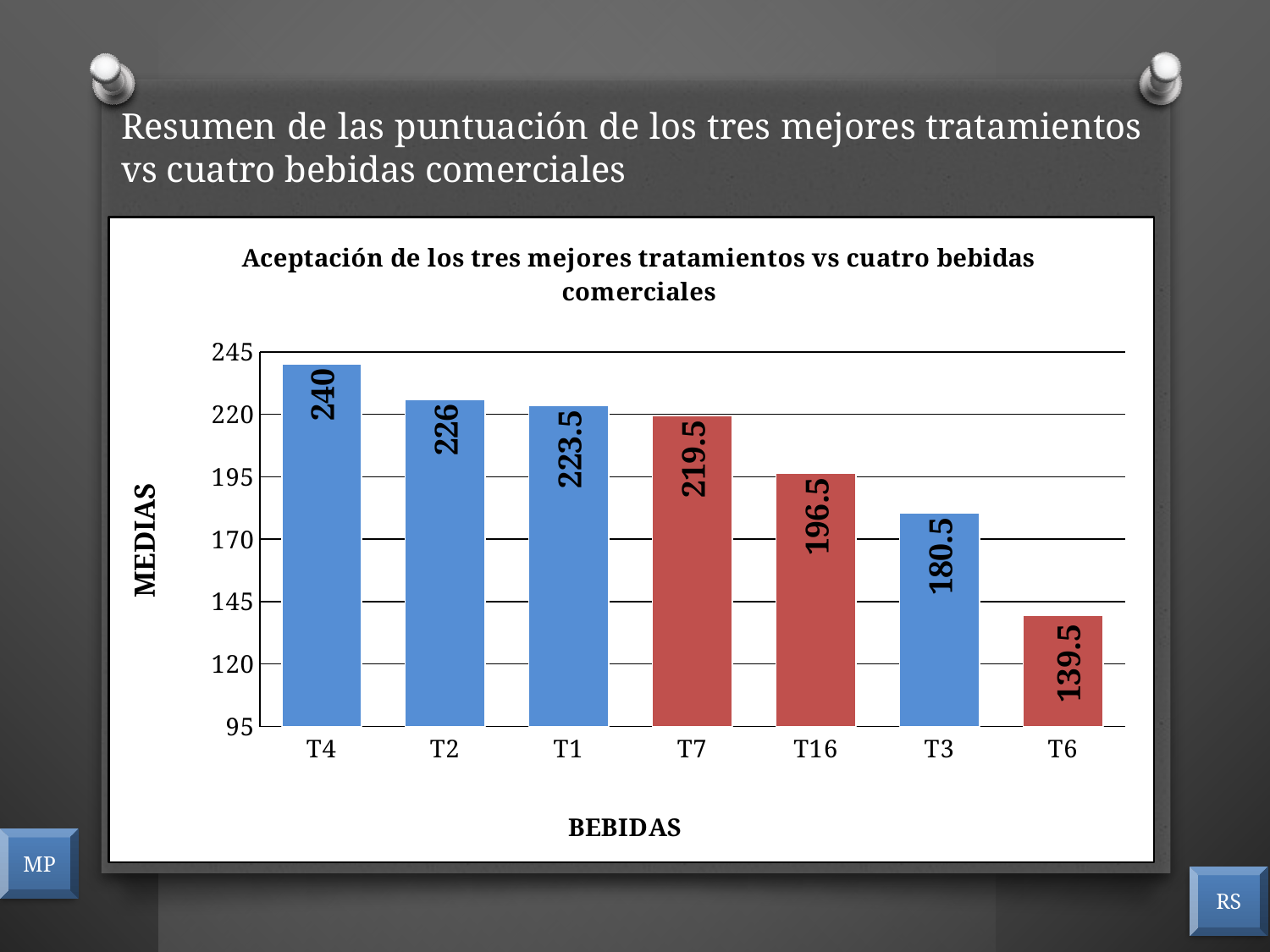
Which category has the highest value? T4 What kind of chart is this? bar chart How many categories are shown on the x axis? 7 What is the value for T7? 219.5 What is the difference between the values for T2 and T1? 2.5 What is the label of the y axis? MEDIAS Which category has the lowest value? T6 What is the difference between the values for T4 and T6? 100.5 Which is larger, the value for T16 or the value for T3? T16 What is the value for T3? 180.5 What is the value for T4? 240 Is the value for T6 greater or less than 145? less